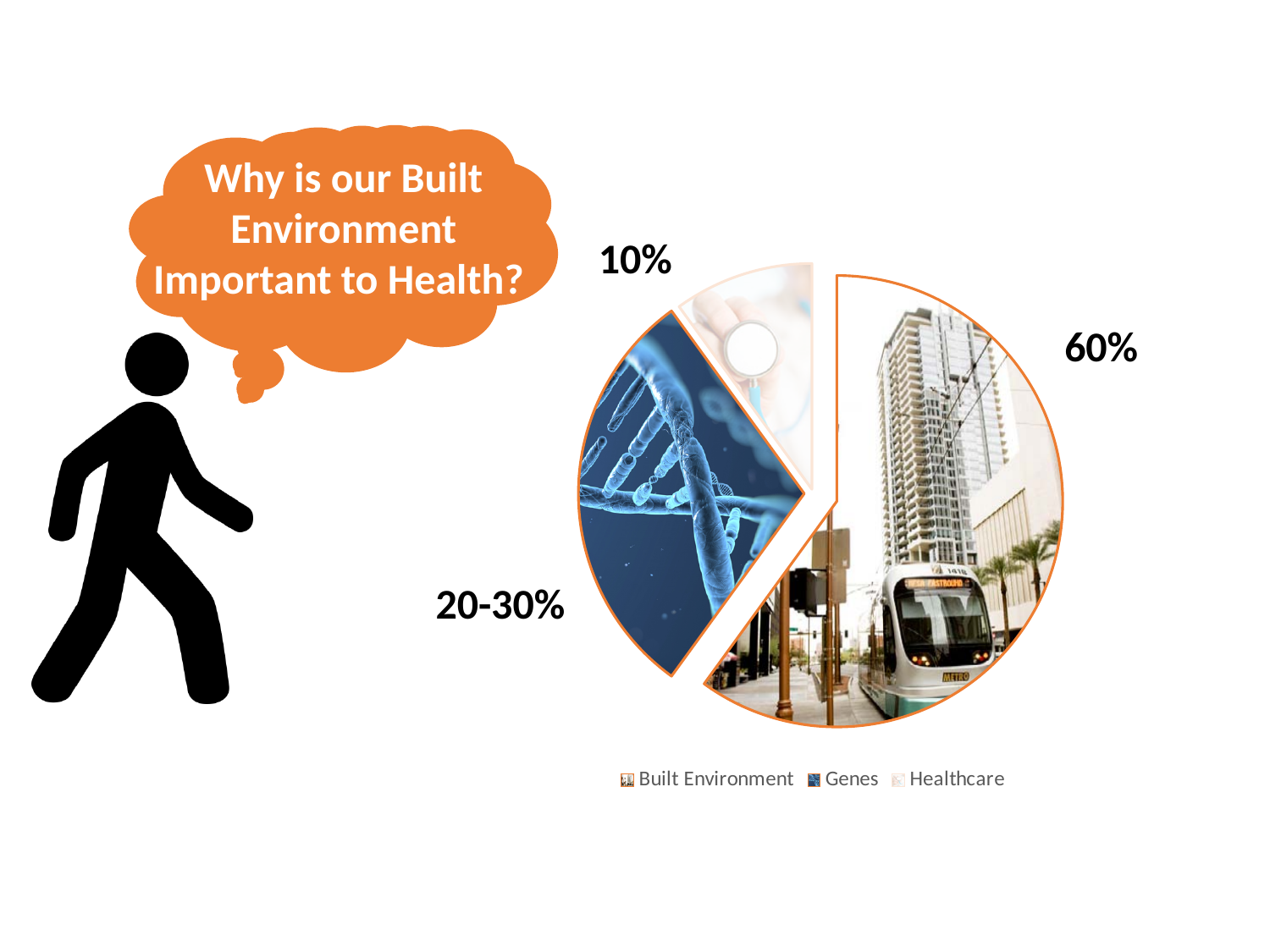
Which category has the smallest slice of the pie? Healthcare What share of the pie is labelled for Healthcare? 10% Which slice is larger, Genes or Healthcare? Genes Which slice is larger, Built Environment or Genes? Built Environment What share of the pie is labelled for Genes? 20-30% How many entries does the legend list? 3 What are the three categories listed in the legend? Built Environment, Genes, Healthcare What kind of chart is shown on the slide? pie chart What question is written in the thought bubble next to the pie chart? Why is our Built Environment Important to Health? How many slices does the pie chart have? 3 What share of the pie is labelled for Built Environment? 60% Which category has the largest slice of the pie? Built Environment